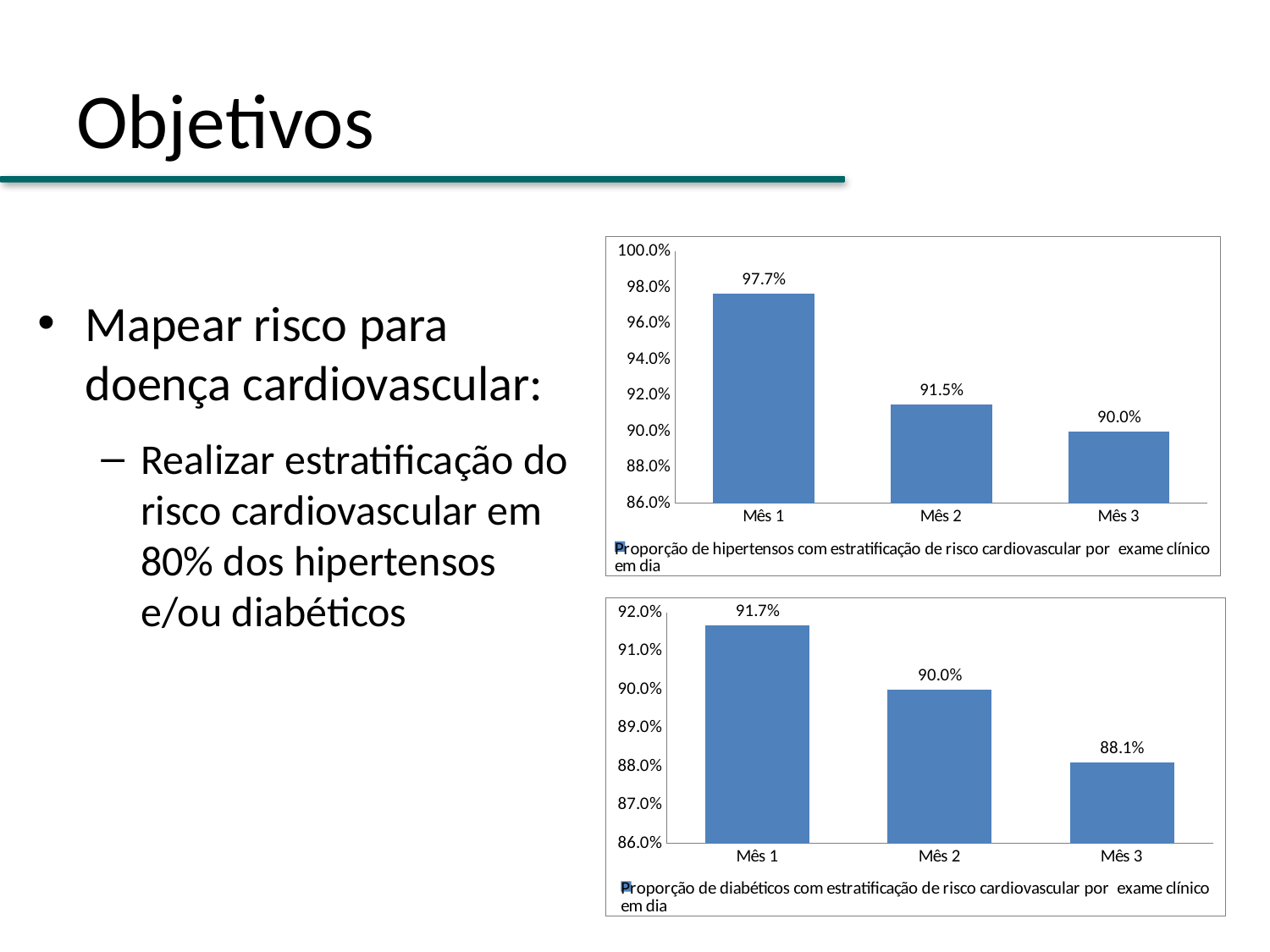
What type of chart is the bottom chart (diabéticos)? Bar chart In the bottom chart (diabéticos), what is the difference between Mês 1 and Mês 3? 3.6% In the top chart (hipertensos), do the values rise or fall from Mês 1 to Mês 3? Fall In the bottom chart (diabéticos), what is the value for Mês 2? 90.0% In the top chart (hipertensos), what is the difference between Mês 1 and Mês 2? 6.2% In the bottom chart (diabéticos), what is the value for Mês 3? 88.1% In the bottom chart (diabéticos), which is larger, the value for Mês 1 or Mês 2? Mês 1 In the bottom chart (diabéticos), which month has the lowest value? Mês 3 In the top chart (hipertensos), what is the value for Mês 1? 97.7% In the top chart (hipertensos), which month has the highest value? Mês 1 In the top chart (hipertensos), what is the value for Mês 3? 90.0% How many months are shown in the top chart (hipertensos)? 3